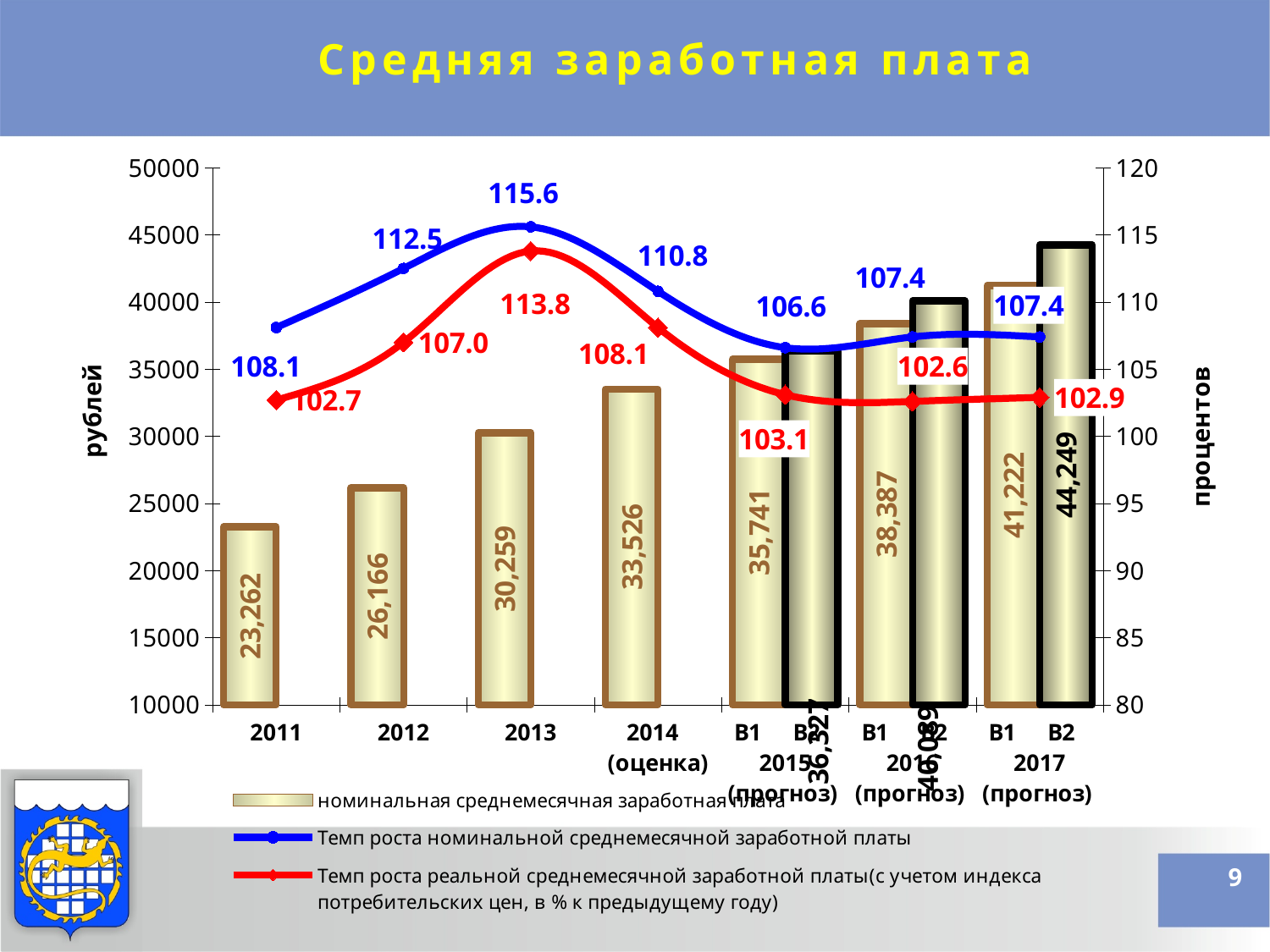
In which year does the growth rate of nominal average monthly wage (blue line) reach its highest value? 2013 What is the nominal average monthly wage shown for 2011? 23,262 Which is larger: the nominal wage for the В1 variant of 2015 or the В1 variant of 2016? В1 2016 What is the nominal average monthly wage shown for the В2 variant of the 2017 forecast? 44,249 What kind of chart is shown on the slide? Combined bar and line chart By how much did the nominal average monthly wage increase from 2011 to 2012? 2,904 What is the label of the left vertical axis? рублей What is the growth rate of real average monthly wage (red line) for 2013? 113.8 Do the nominal average monthly wage bars rise or fall from 2011 to 2017? Rise What is the growth rate of nominal average monthly wage (blue line) for 2014? 110.8 What is the difference between the nominal growth rate and the real growth rate in 2013? 1.8 How many series does the legend list? 3